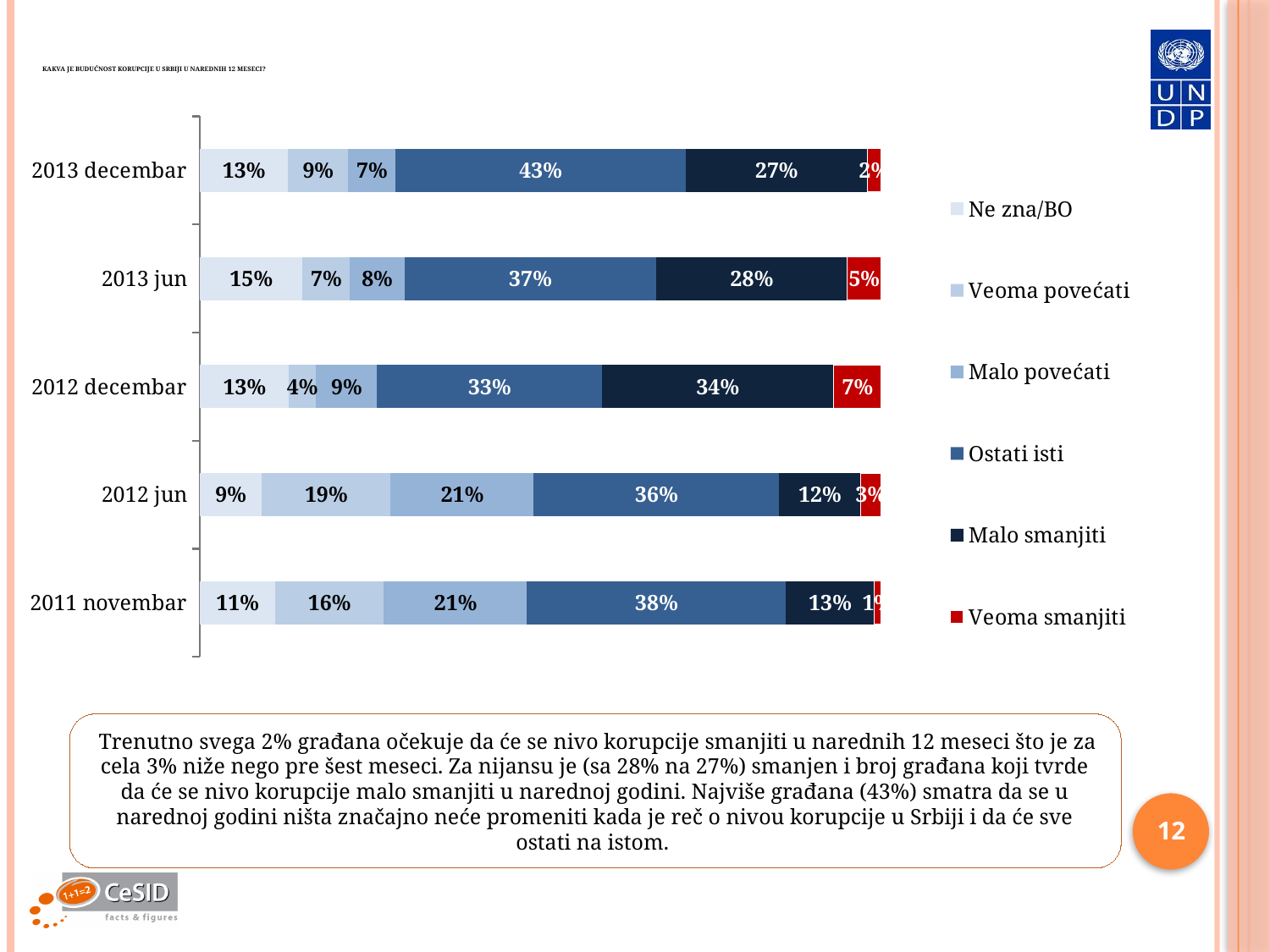
What is the value for "Ne zna/BO" in 2013 jun? 15% What is the difference between the "Ostati isti" values for 2013 decembar and 2012 decembar? 10% Which is larger: the "Malo povećati" value for 2012 jun or for 2013 decembar? 2012 jun What is the value for "Ostati isti" in 2013 decembar? 43% How many series does the legend list? 6 In which period is the "Ostati isti" value the highest? 2013 decembar What is the value for "Veoma povećati" in 2012 jun? 19% In which period is the "Malo smanjiti" value the highest? 2012 decembar How many time periods are shown on the chart? 5 What is the value for "Veoma smanjiti" in 2012 decembar? 7% What is the difference between the "Malo smanjiti" values for 2013 jun and 2013 decembar? 1% In which period is the "Veoma smanjiti" value the lowest? 2011 novembar